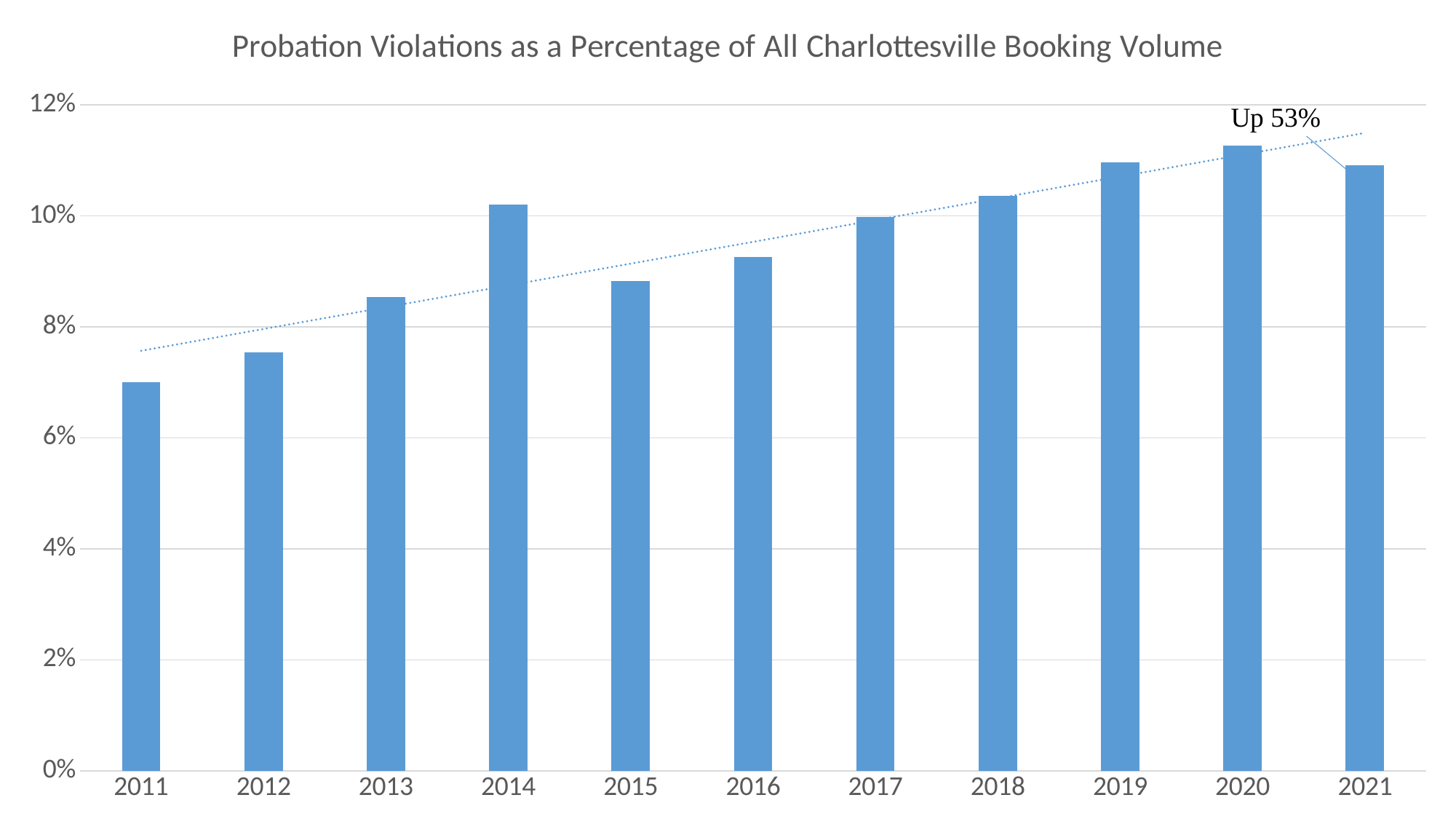
Which year has the lowest percentage of probation violations? 2011 What kind of chart is shown on the slide? Bar chart Which year has the larger value, 2014 or 2015? 2014 Is the value for 2016 greater or less than 10%? less Is the value for 2011 greater or less than 8%? less Is the value for 2014 greater or less than 10%? greater What does the text annotation near the top right of the chart say? Up 53% Which year has the highest percentage of probation violations? 2020 How many years are shown on the x axis of the chart? 11 What is the title of the chart? Probation Violations as a Percentage of All Charlottesville Booking Volume Do the values generally rise or fall from 2011 to 2021? Rise